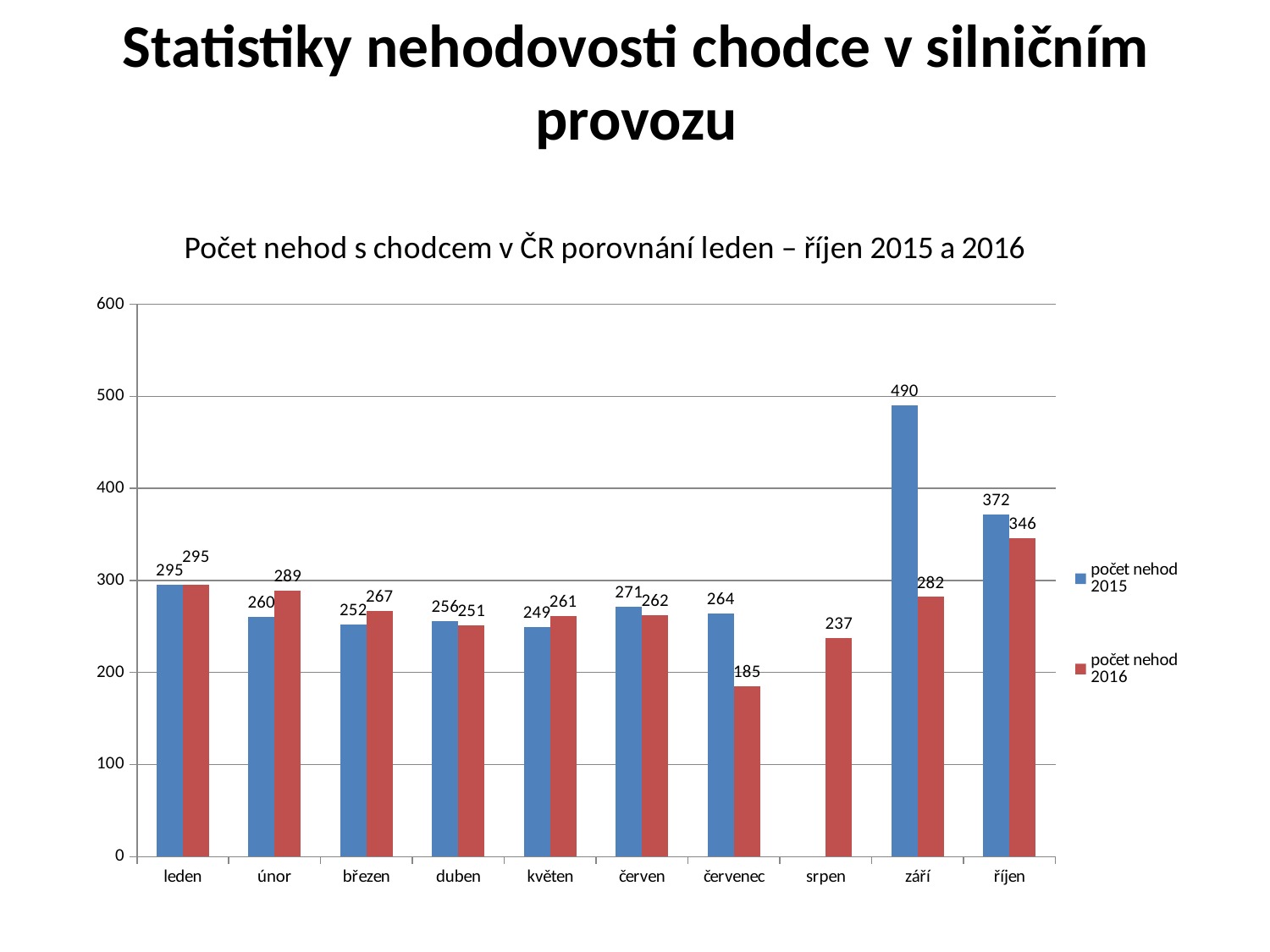
What is the title of the chart? Počet nehod s chodcem v ČR porovnání leden – říjen 2015 a 2016 What is the value for počet nehod 2016 in srpen? 237 Which month has the highest value for počet nehod 2015? září Is the value for počet nehod 2015 in říjen greater or less than 300? greater How many months are shown on the x axis? 10 What type of chart is shown on the slide? bar chart Which is larger in únor: počet nehod 2015 or počet nehod 2016? počet nehod 2016 What is the difference between počet nehod 2015 and počet nehod 2016 in září? 208 How many series does the legend list? 2 Which month has the lowest value for počet nehod 2016? červenec What is the value for počet nehod 2015 in září? 490 What is the value for počet nehod 2016 in červenec? 185